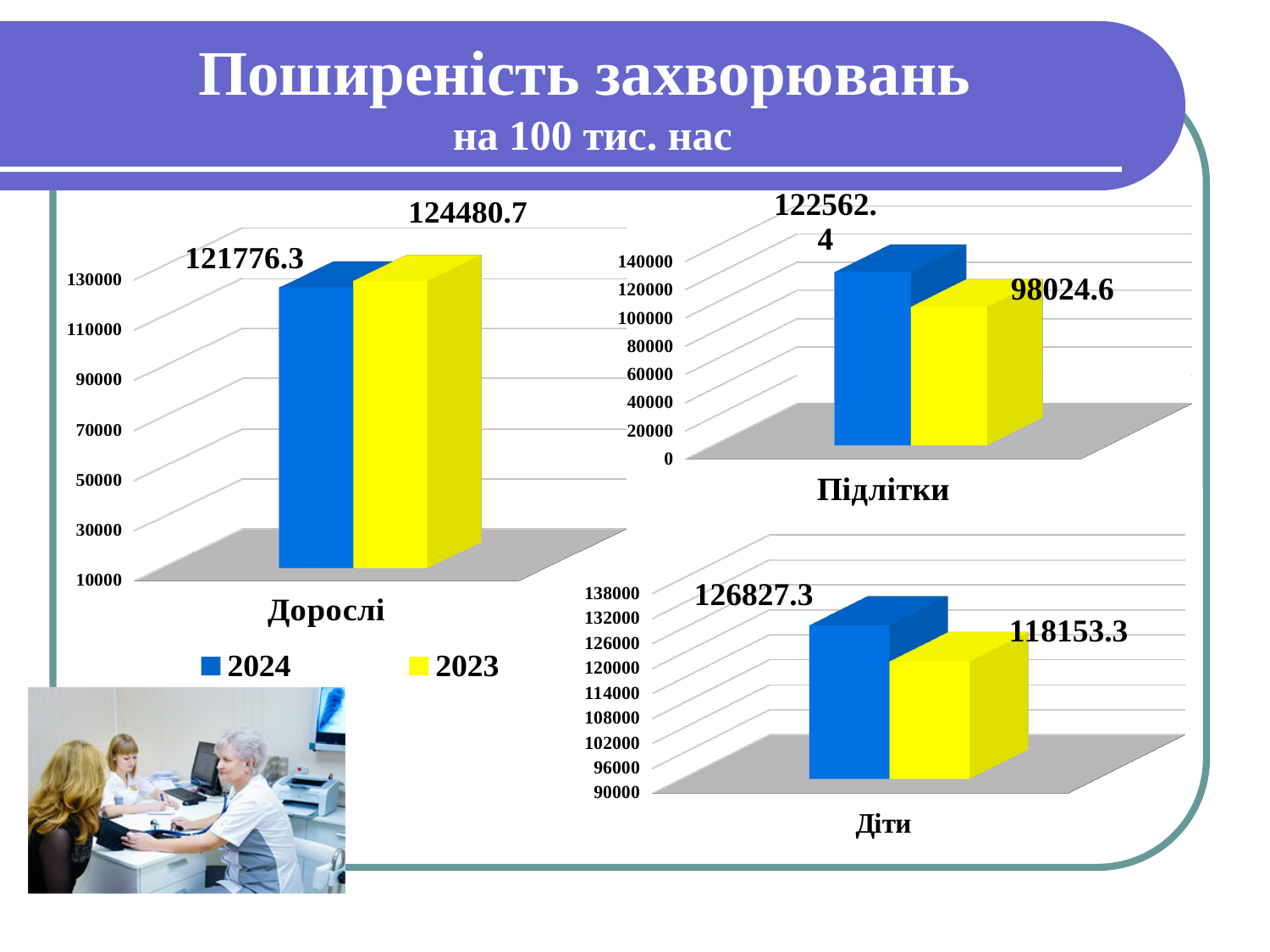
In the Дорослі chart, what is the value for 2024? 121776.3 In the Дорослі chart, what is the value for 2023? 124480.7 In the Діти chart, what is the value of the yellow bar? 118153.3 How many series does the legend of the Дорослі chart list? 2 In the Підлітки chart, what is the difference between the blue bar and the yellow bar? 24537.8 In the Діти chart, what is the value of the blue bar? 126827.3 In the Дорослі chart, what is the difference between the 2023 and 2024 values? 2704.4 What kind of chart is the Діти chart? bar chart In the Діти chart, which bar is taller, the blue one or the yellow one? blue In the Підлітки chart, what is the value of the yellow bar? 98024.6 In the Дорослі chart, which is larger, the 2024 value or the 2023 value? 2023 In the Підлітки chart, what is the value of the blue bar? 122562.4